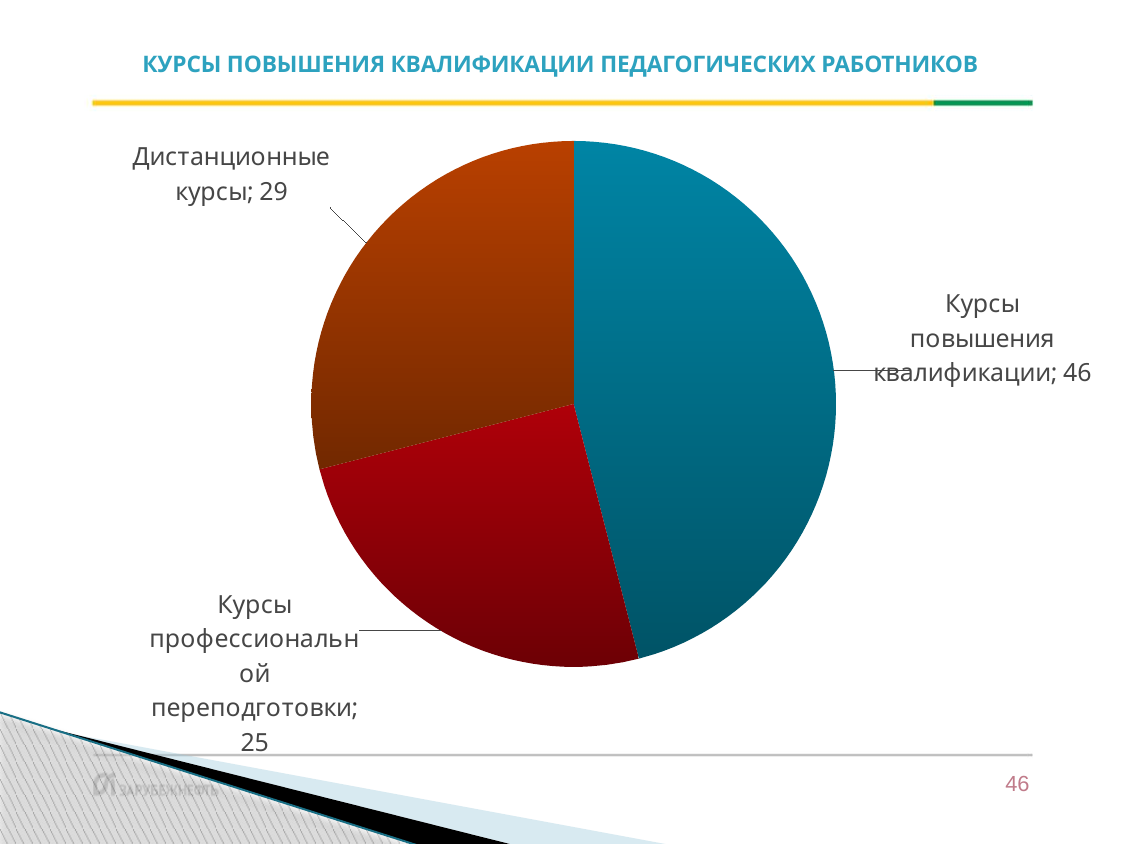
Which category has the smallest slice? Курсы профессиональной переподготовки Which is larger: "Дистанционные курсы" or "Курсы профессиональной переподготовки"? Дистанционные курсы What is the value for "Дистанционные курсы"? 29 What is the value for "Курсы повышения квалификации"? 46 What is the difference between the values for "Дистанционные курсы" and "Курсы профессиональной переподготовки"? 4 What is the difference between the values for "Курсы повышения квалификации" and "Дистанционные курсы"? 17 Which category has the largest slice? Курсы повышения квалификации What is the title of the slide containing the chart? КУРСЫ ПОВЫШЕНИЯ КВАЛИФИКАЦИИ ПЕДАГОГИЧЕСКИХ РАБОТНИКОВ What share of the pie does "Курсы повышения квалификации" represent? 46% What type of chart is shown on the slide? Pie chart How many slices does the pie chart have? 3 What is the value for "Курсы профессиональной переподготовки"? 25